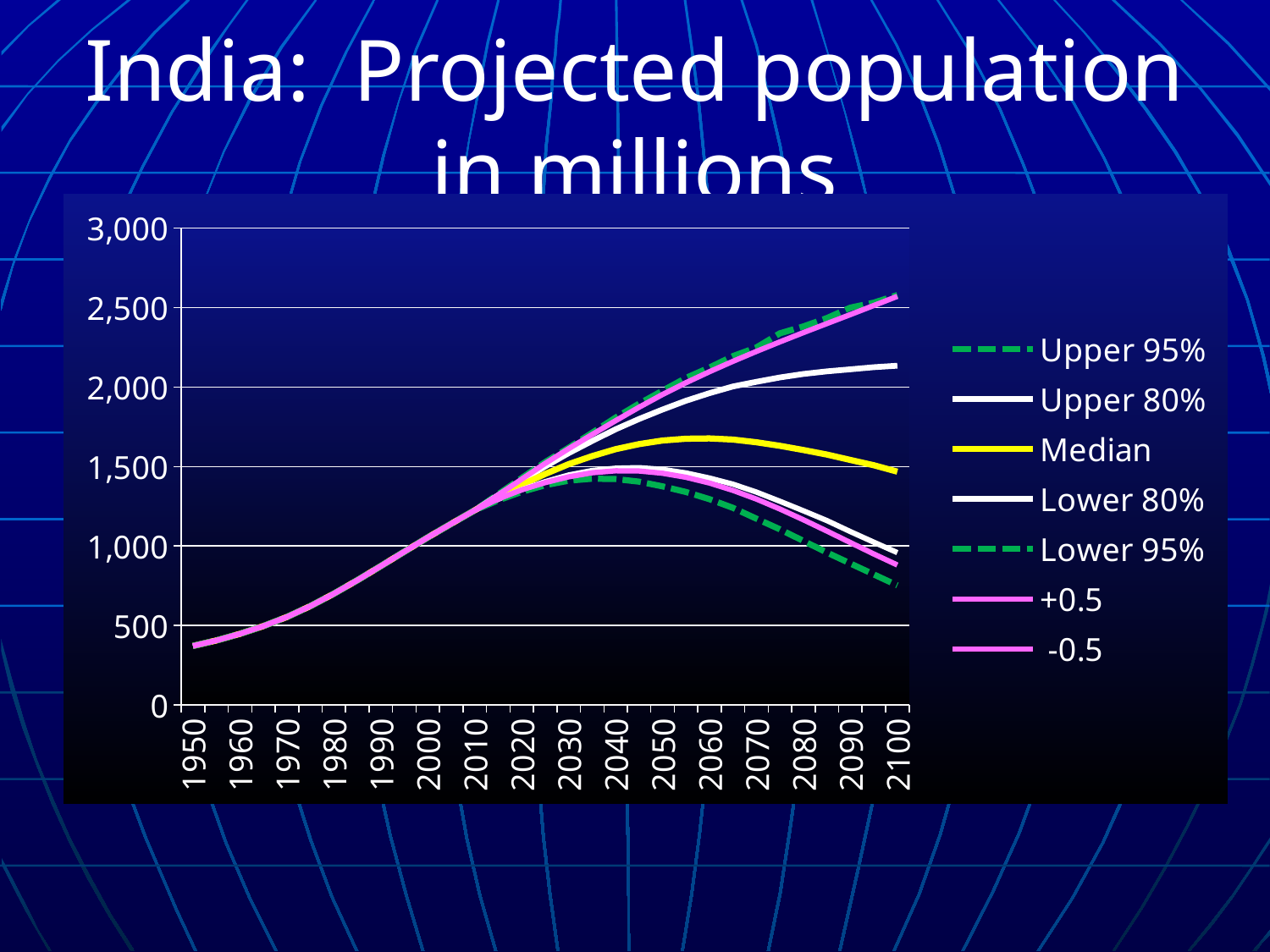
Is the value of the Upper 95% series in 2100 greater or less than 2,500? greater Is the value of the Upper 80% series in 2100 greater or less than 2,000? greater Does the Median series rise or fall between 2060 and 2100? fall What is the title of the chart on the slide? India: Projected population in millions What kind of chart is shown on the slide? line chart How many year labels are shown along the x axis? 16 In 2100, which is larger: the Upper 80% series or the Median series? Upper 80% Which series has the lowest value in 2100? Lower 95% Which series is drawn as a yellow line? Median Is the value of the Lower 95% series in 2100 greater or less than 1,000? less How many series does the legend list? 7